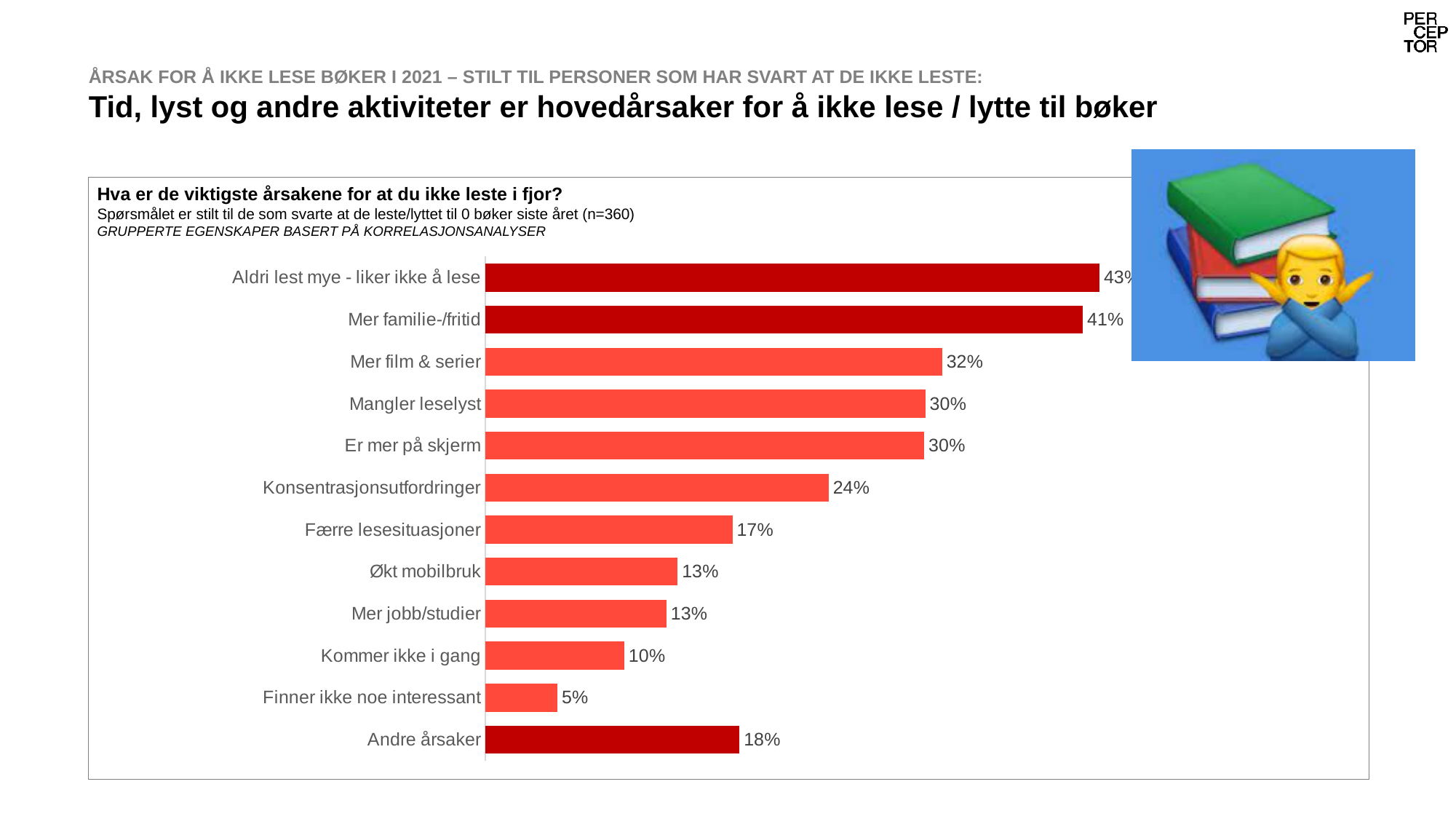
Which category has the lowest value? Finner ikke noe interessant How many categories are shown in the chart? 12 What is the value for "Konsentrasjonsutfordringer"? 24% What kind of chart is shown on the slide? Bar chart What is the value for "Andre årsaker"? 18% What is the value for "Kommer ikke i gang"? 10% What is the value for "Finner ikke noe interessant"? 5% What is the sample size (n) stated in the chart subtitle? n=360 Which category has the highest value? Aldri lest mye - liker ikke å lese What is the value for "Mer familie-/fritid"? 41% Which is larger, the value for "Mer familie-/fritid" or the value for "Mer film & serier"? Mer familie-/fritid What is the difference between the values for "Mer film & serier" and "Færre lesesituasjoner"? 15%